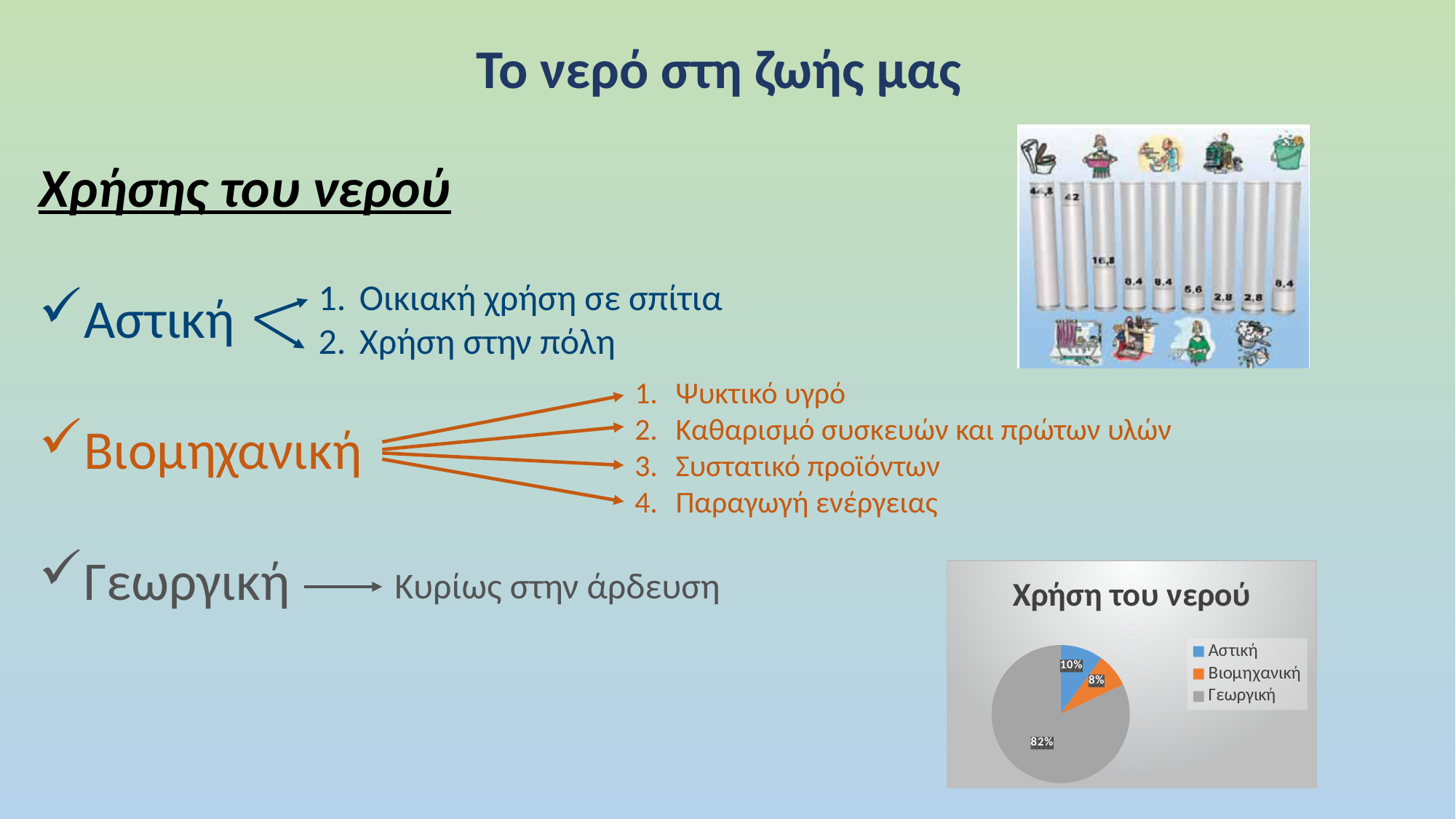
How many entries does the legend of the pie chart titled "Χρήση του νερού" list? 3 In the pie chart titled "Χρήση του νερού", which category has the smallest slice? Βιομηχανική In the pie chart titled "Χρήση του νερού", what percentage is shown for Βιομηχανική? 8% How many slices does the pie chart titled "Χρήση του νερού" have? 3 In the pie chart titled "Χρήση του νερού", what percentage is shown for Γεωργική? 82% In the pie chart titled "Χρήση του νερού", what percentage is shown for Αστική? 10% In the pie chart titled "Χρήση του νερού", which is larger, Αστική or Βιομηχανική? Αστική In the pie chart titled "Χρήση του νερού", which category has the largest slice? Γεωργική What kind of chart is the chart titled "Χρήση του νερού" at the bottom right of the slide? Pie chart In the pie chart titled "Χρήση του νερού", what is the difference in percentage points between Γεωργική and Αστική? 72 In the pie chart titled "Χρήση του νερού", what is the difference in percentage points between Αστική and Βιομηχανική? 2 In the pie chart titled "Χρήση του νερού", what colour is the Βιομηχανική slice? Orange